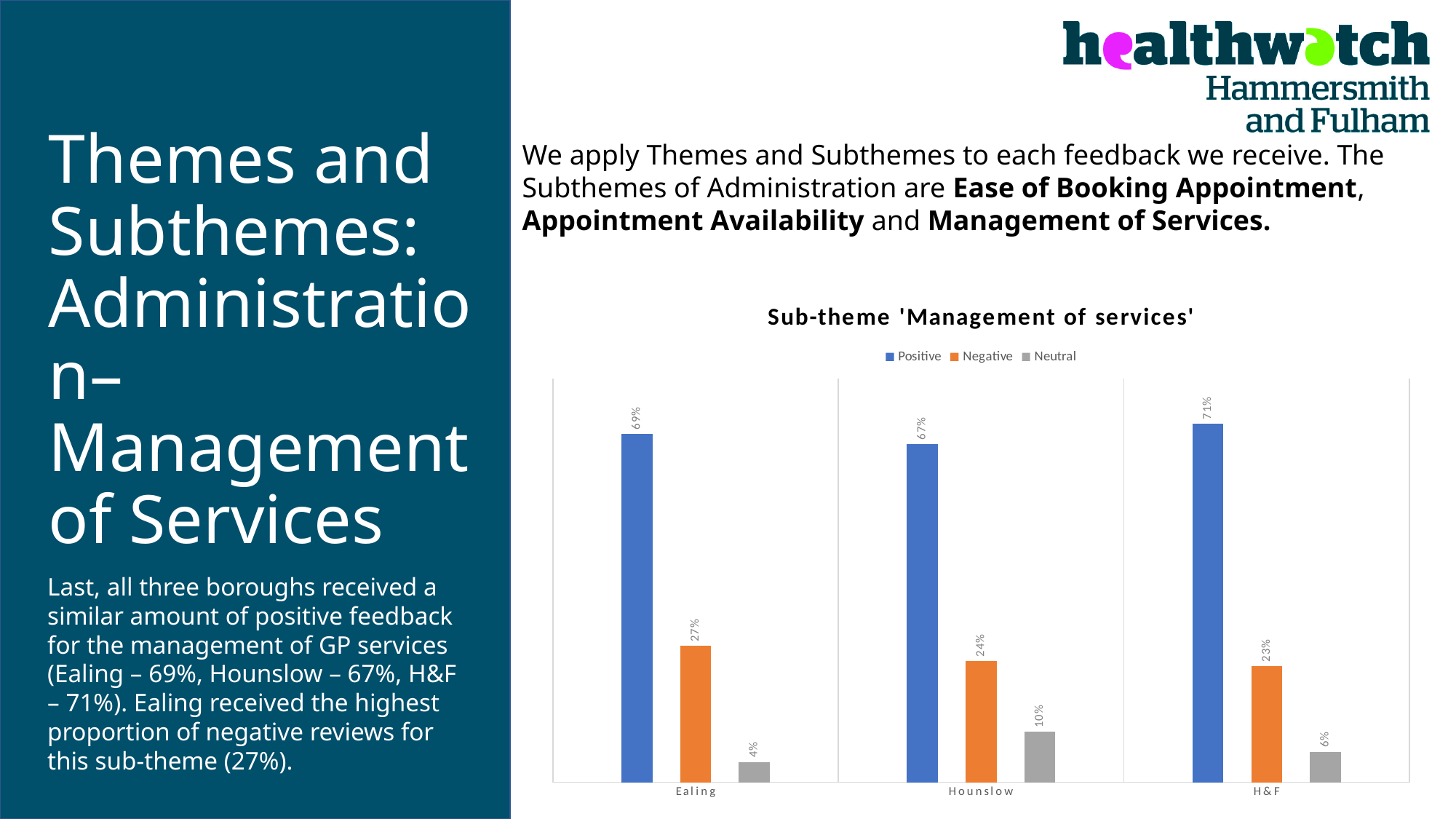
How many series does the legend list? 3 What is the Neutral value for H&F? 6% What kind of chart is shown? Bar chart How many boroughs are shown on the x axis? 3 Which borough has the highest Positive value? H&F What is the title of the chart? Sub-theme 'Management of services' What is the Negative value for Hounslow? 24% What is the Positive value for Ealing? 69% What is the difference between the Positive and Negative values for Ealing? 42% Which is larger, the Negative value for Ealing or the Negative value for H&F? Ealing Which borough has the lowest Neutral value? Ealing Which colour represents the Negative series? Orange